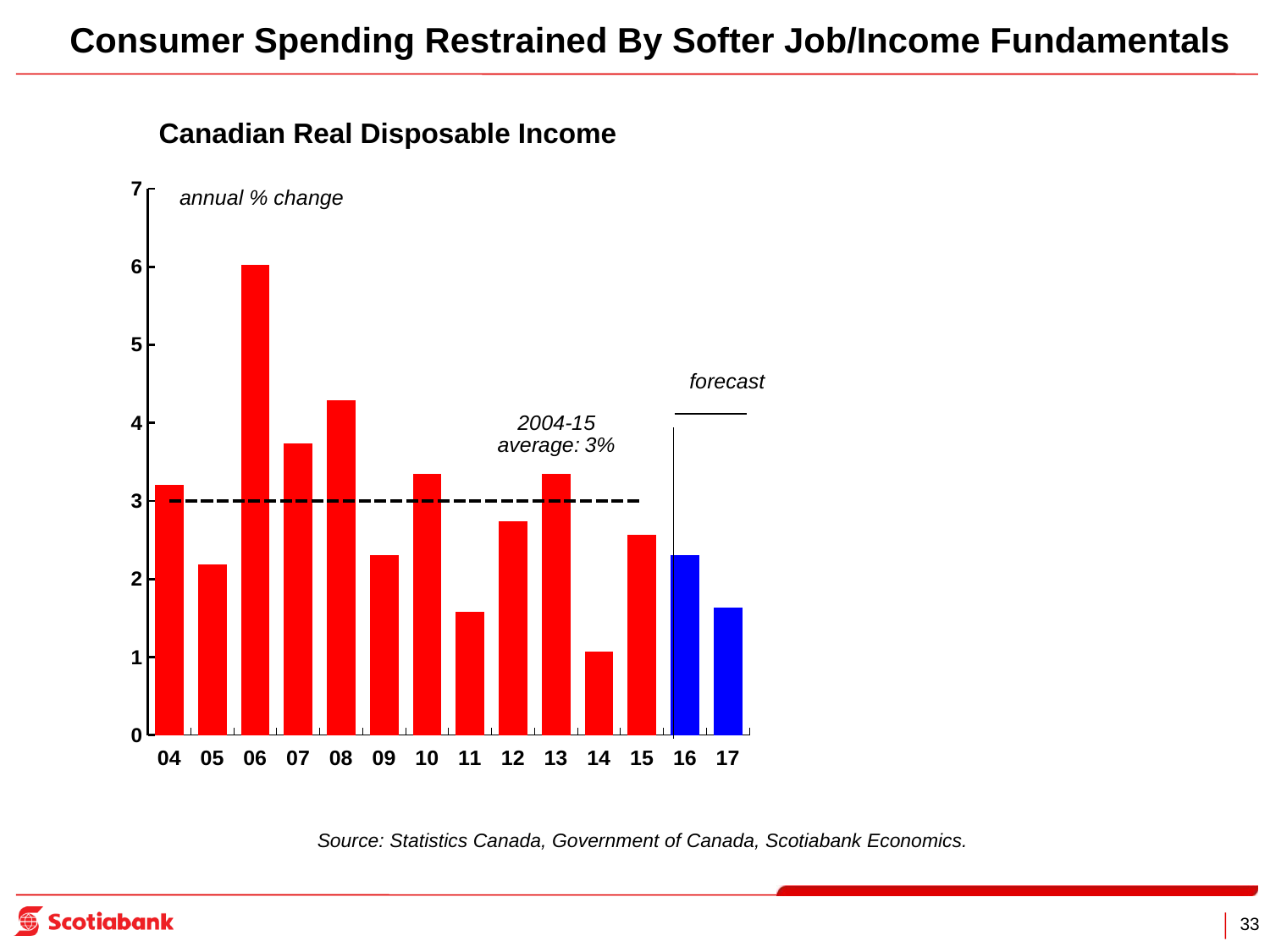
Which year has the larger value, 07 or 09? 07 Which year has the highest annual % change in Canadian real disposable income? 06 Is the value for 14 greater or less than 2? less Do the values rise or fall from 15 to 17? fall Is the value for 06 greater or less than 5? greater Is the value for 08 greater or less than 4? greater What is the 2004-15 average annual % change shown by the dashed line? 3% How many years are plotted on the x axis of the chart? 14 Which year has the larger value, 16 or 17? 16 What kind of chart is shown on the slide? bar chart Which year has the lowest annual % change in Canadian real disposable income? 14 What is the title of the chart? Canadian Real Disposable Income